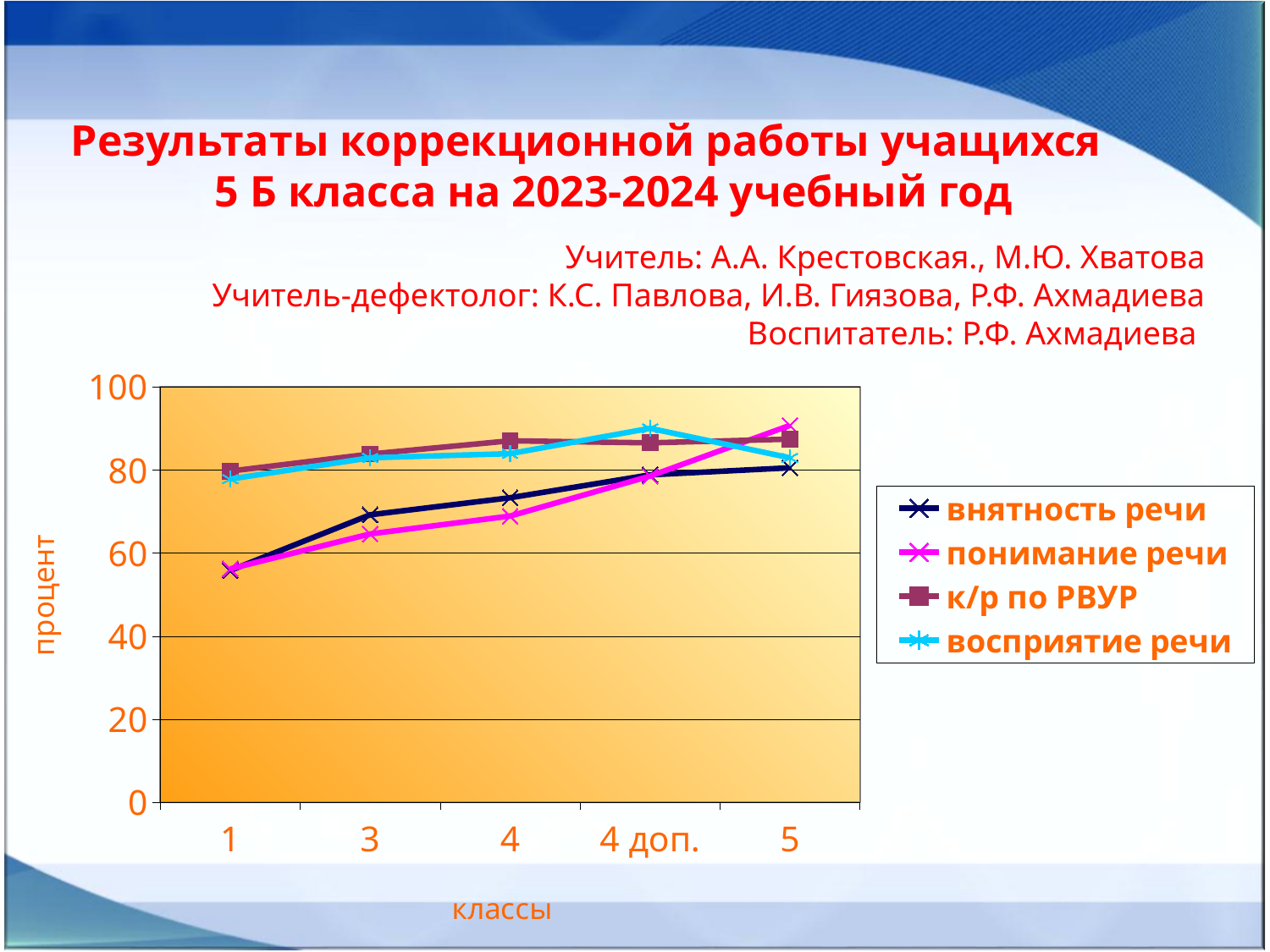
At class 5, which is higher: понимание речи or внятность речи? понимание речи What kind of chart is shown on the slide? line chart At class 1, which is higher: к/р по РВУР or внятность речи? к/р по РВУР Is the value for восприятие речи at class 4 доп. greater or less than 80? greater What is the label of the vertical axis? процент How many categories are shown on the x axis? 5 Is the value for к/р по РВУР at class 1 greater or less than 60? greater Which series has the highest value at class 5? понимание речи Is the value for понимание речи at class 5 greater or less than 80? greater How many series does the legend list? 4 Does the внятность речи line rise or fall from class 1 to class 5? rise